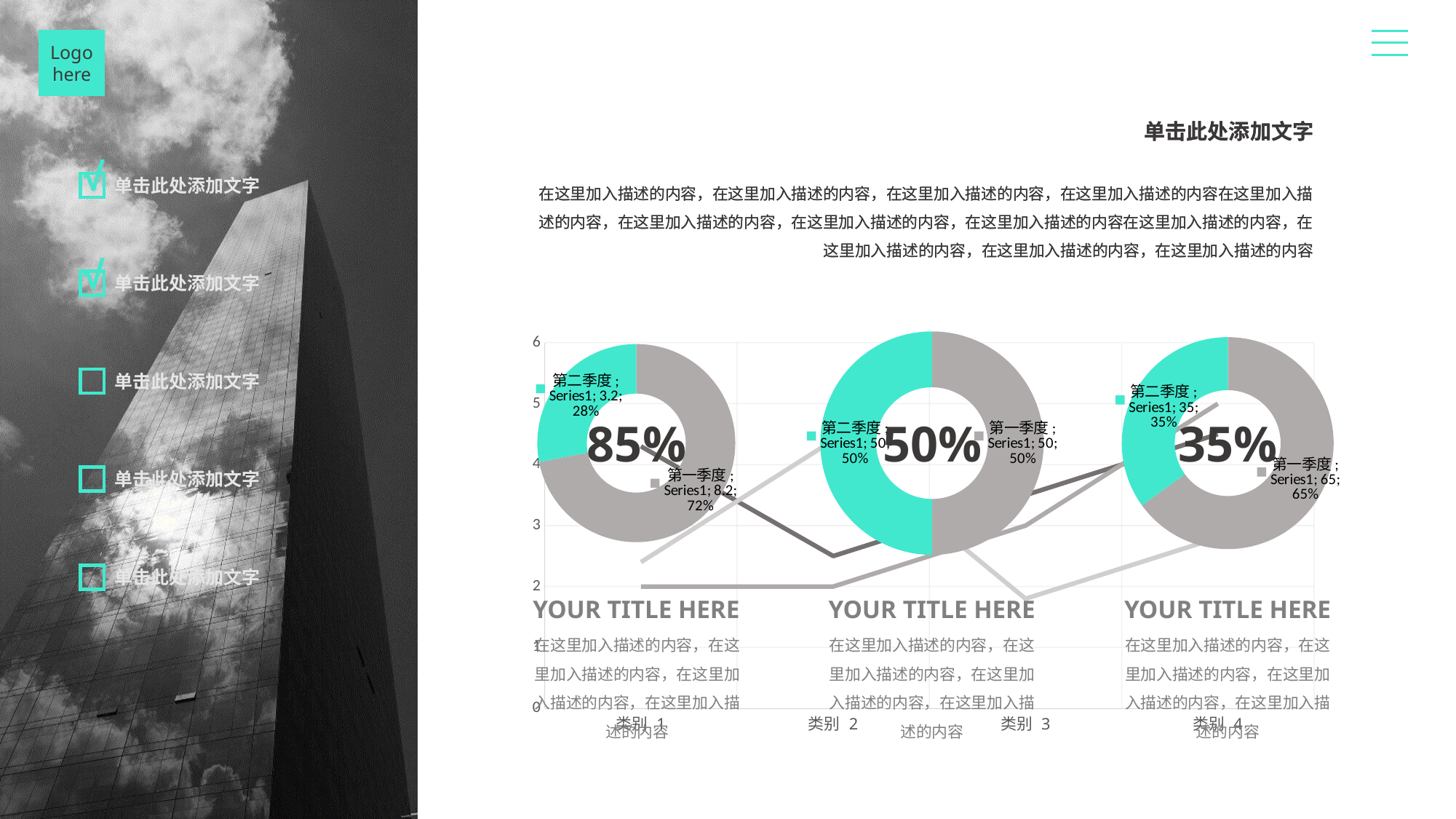
In the right doughnut chart, what is the difference between the values for 第一季度 and 第二季度? 30 What kind of chart are the three charts with 第一季度 and 第二季度 slices? Doughnut chart In the middle doughnut chart, what share does 第二季度 represent? 50% In the left doughnut chart, what is the difference between the values for 第一季度 (8.2) and 第二季度 (3.2)? 5 How many slices does the left doughnut chart have? 2 In the left doughnut chart, what is the value for 第二季度? 3.2 In the right doughnut chart, what share does 第二季度 represent? 35% In the right doughnut chart, which slice is larger, 第一季度 or 第二季度? 第一季度 In the left doughnut chart, which is larger, 第一季度 or 第二季度? 第一季度 In the right doughnut chart, what is the value for 第一季度? 65 In the middle doughnut chart, what is the value for 第一季度? 50 In the left doughnut chart, what share of the whole does 第一季度 represent? 72%